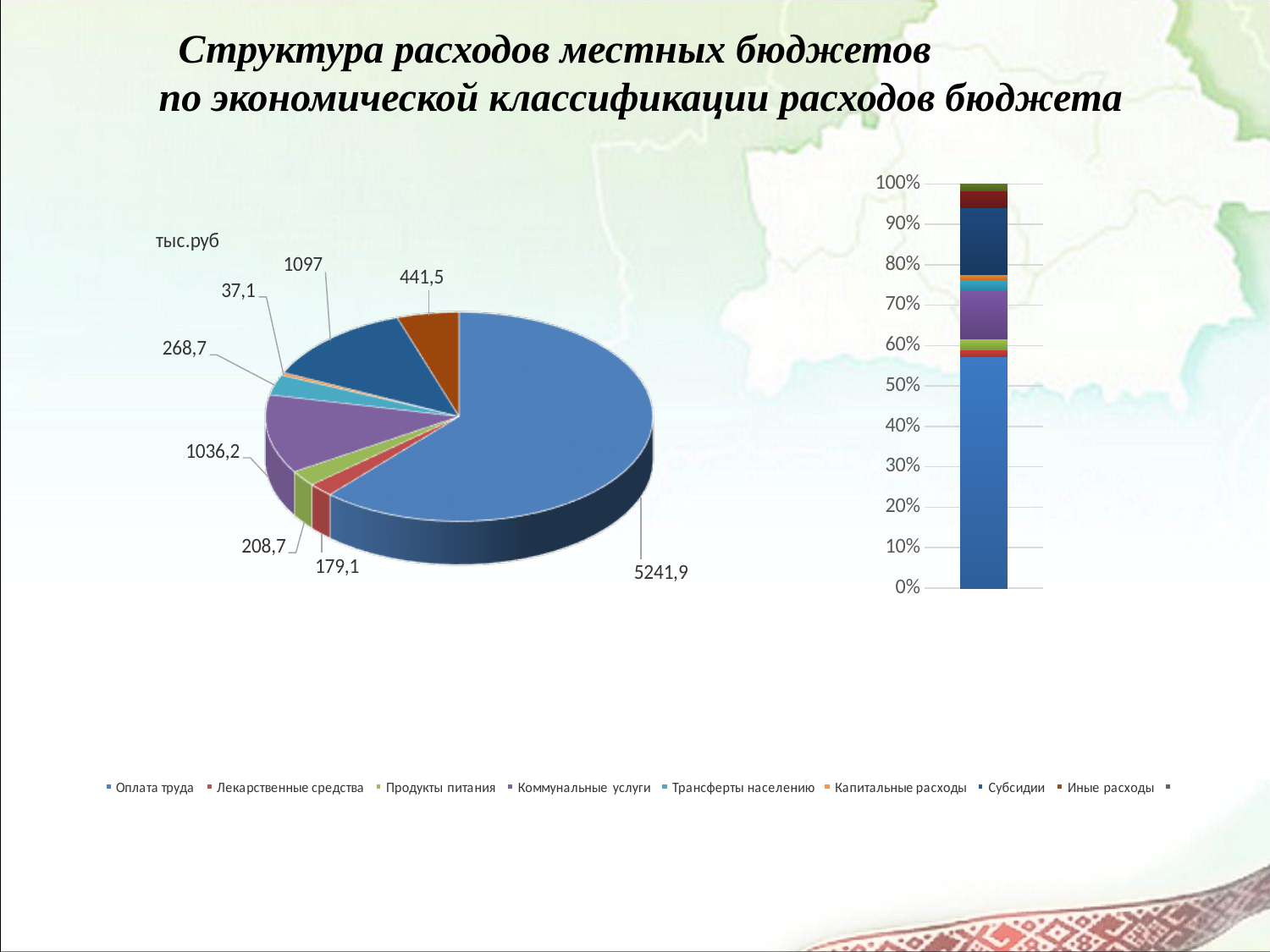
What unit is shown above the pie chart? тыс.руб In the pie chart, what is the value for Субсидии? 1097 In the pie chart, which category has the smallest value? Капитальные расходы In the pie chart, which category has the largest value? Оплата труда In the pie chart, what is the value for Оплата труда? 5241,9 In the pie chart, what is the value for Коммунальные услуги? 1036,2 In the pie chart, what is the value for Капитальные расходы? 37,1 In the pie chart, what is the difference between the values for Иные расходы and Трансферты населению? 172,8 How many slices does the pie chart have? 8 In the pie chart, what is the difference between the values for Субсидии and Коммунальные услуги? 60,8 In the stacked bar chart on the right, is the share for Оплата труда greater or less than 50%? greater In the pie chart, which is larger: Продукты питания or Лекарственные средства? Продукты питания